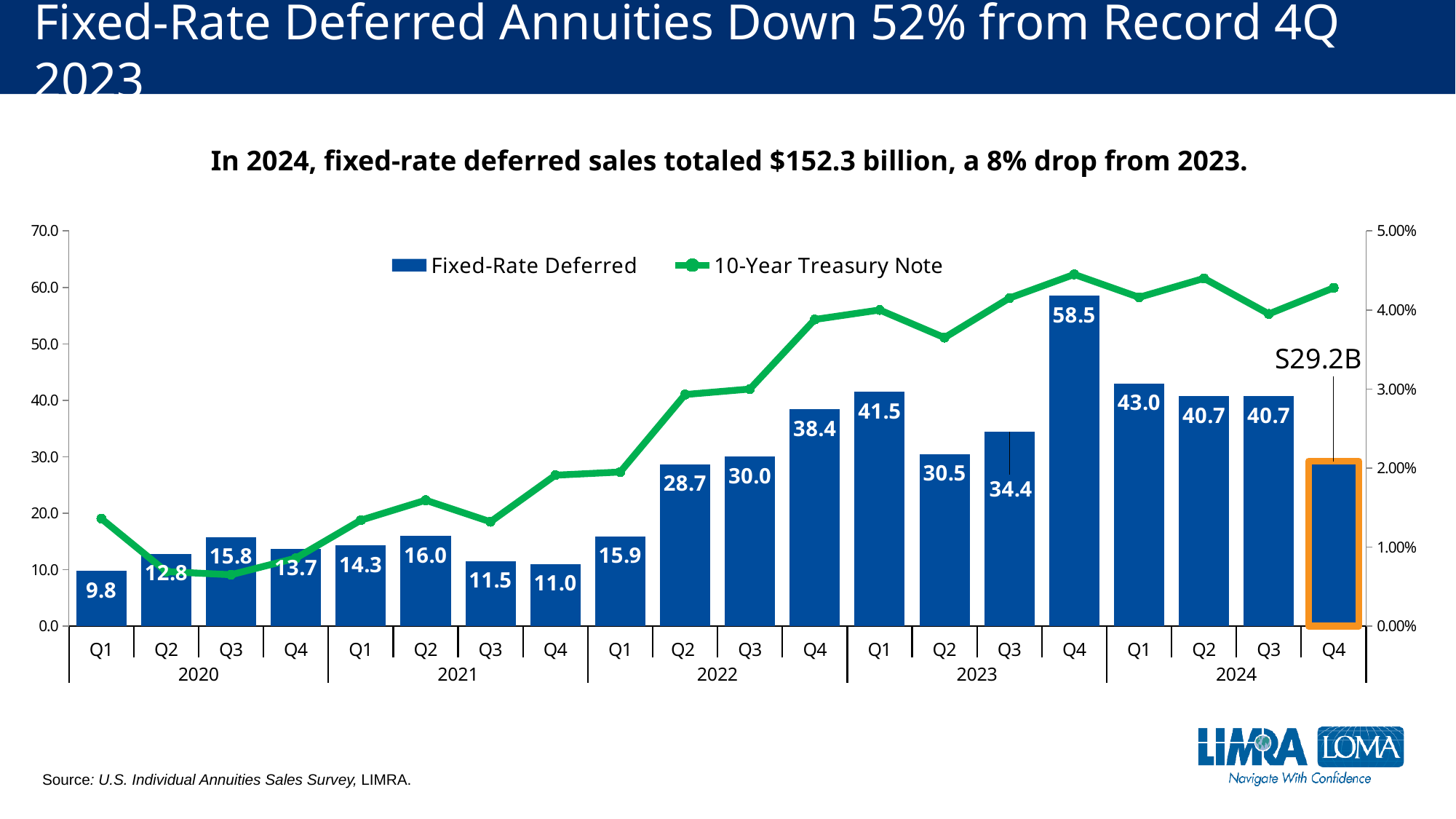
Does the 10-Year Treasury Note line rise or fall from Q1 2022 to Q4 2022? rise How many series does the legend list? 2 Which quarter has the lowest Fixed-Rate Deferred value? Q1 2020 Is the 10-Year Treasury Note value for Q4 2023 greater or less than 4.00%? greater What is the difference between the Fixed-Rate Deferred values for Q4 2023 and Q1 2024? 15.5 What value is annotated for the Q4 2024 bar? $29.2B What is the Fixed-Rate Deferred value for Q1 2020? 9.8 Which is larger, the Fixed-Rate Deferred value for Q1 2023 or for Q4 2022? Q1 2023 How many quarterly bars are plotted in the chart? 20 Which quarter has the highest Fixed-Rate Deferred value? Q4 2023 What is the Fixed-Rate Deferred value for Q4 2023? 58.5 What is the Fixed-Rate Deferred value for Q2 2022? 28.7